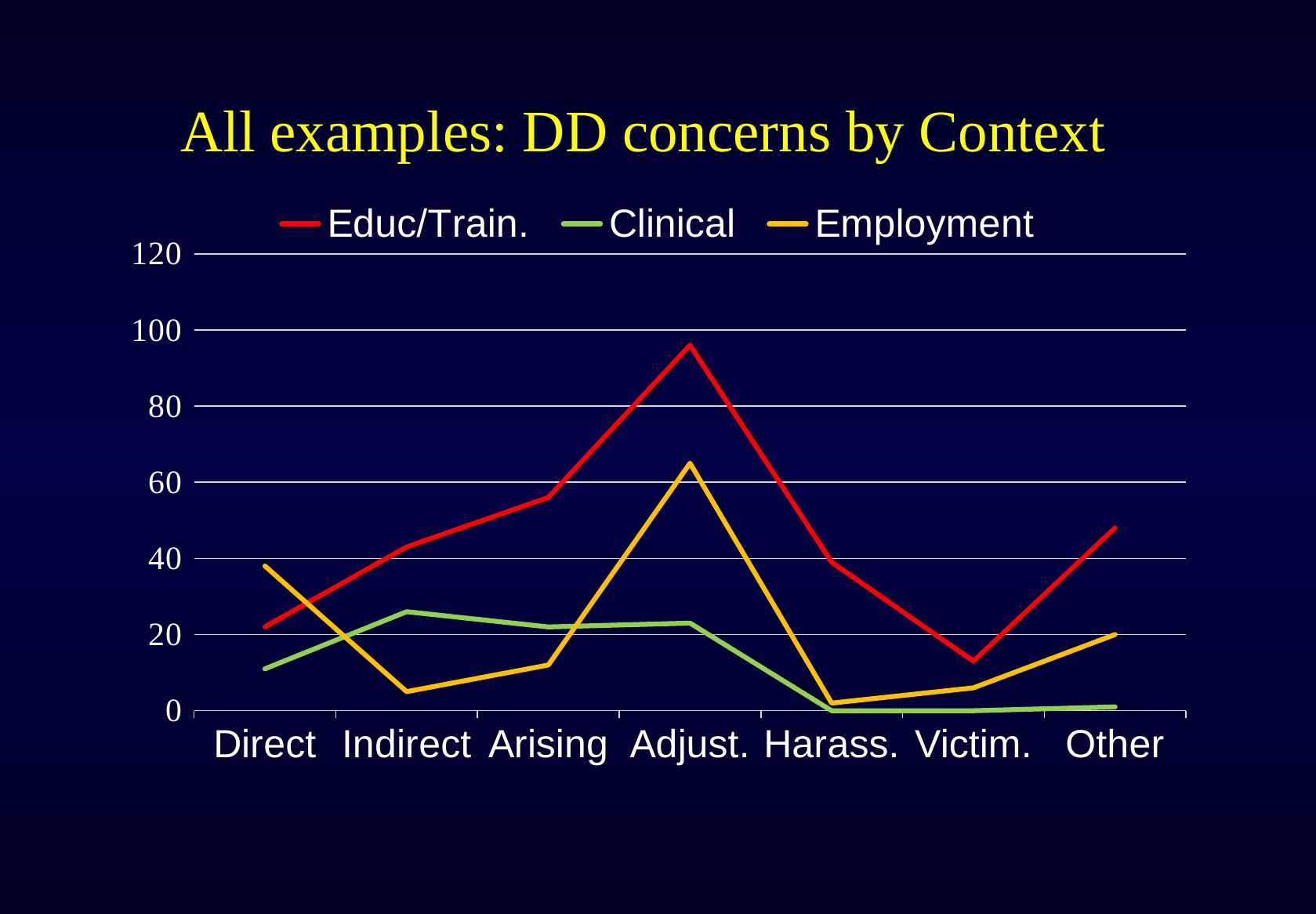
For the Direct category, which series has the larger value: Educ/Train. or Employment? Employment Does the Educ/Train. series rise or fall from Direct to Adjust.? rise Is the Employment value for Adjust. greater or less than 80? less How many series does the legend list? 3 What kind of chart is shown on the slide? line chart For the Other category, which series has the larger value: Educ/Train. or Employment? Educ/Train. Is the Educ/Train. value for Adjust. greater or less than 80? greater For which category is the Employment series highest? Adjust. For which category is the Educ/Train. series highest? Adjust. For which category is the Educ/Train. series lowest? Victim. Is the Clinical value for Indirect greater or less than 20? greater How many categories are shown along the x axis? 7